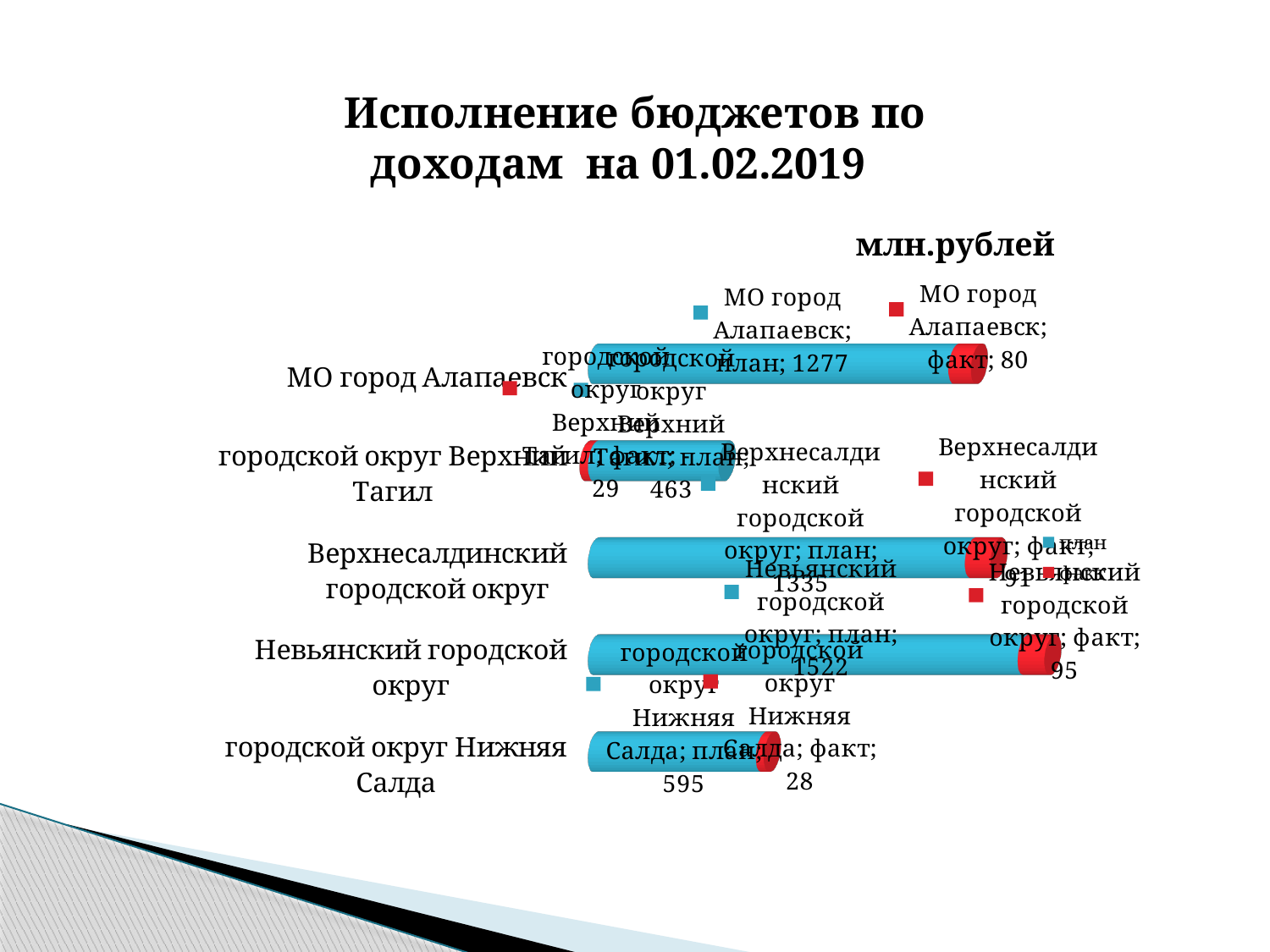
How many categories are shown on the chart? 5 What is the difference between the план and факт values for МО город Алапаевск? 1197 Which category has the lowest план value? городской округ Верхний Тагил How many series does the legend list? 2 What is the факт value for МО город Алапаевск? 80 What is the план value for городской округ Нижняя Салда? 595 Which is larger: the план value for Верхнесалдинский городской округ or the план value for МО город Алапаевск? Верхнесалдинский городской округ What type of chart is shown on the slide? bar chart What is the план value for Невьянский городской округ? 1522 What unit is stated for the chart values? млн.рублей What is the факт value for городской округ Верхний Тагил? 29 Which category has the highest план value? Невьянский городской округ